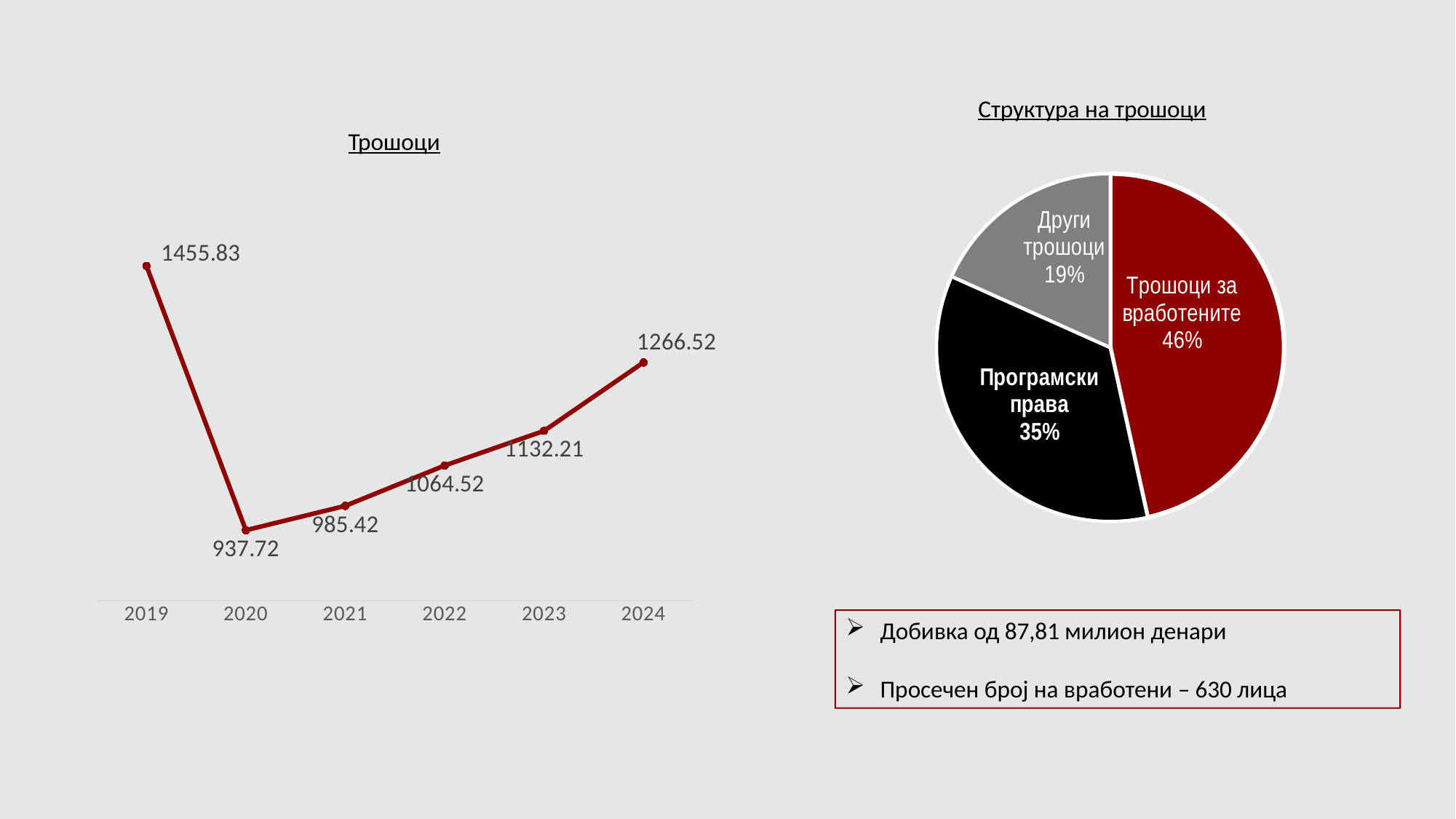
In the 'Трошоци' chart, which year has the highest value? 2019 In the 'Трошоци' chart, what is the value for 2022? 1064.52 In the 'Структура на трошоци' pie chart, which slice is the largest? Трошоци за вработените In the 'Трошоци' chart, how many years are plotted on the x axis? 6 In the 'Структура на трошоци' pie chart, how many slices are there? 3 In the 'Трошоци' chart, which is larger, the value for 2021 or the value for 2020? 2021 In the 'Трошоци' chart, do the values rise or fall from 2020 to 2024? rise In the 'Структура на трошоци' pie chart, what share does 'Програмски права' have? 35% In the 'Трошоци' chart, what is the value for 2019? 1455.83 In the 'Трошоци' chart, what is the difference between the values for 2024 and 2023? 134.31 What kind of chart is the 'Трошоци' chart? line chart In the 'Трошоци' chart, which year has the lowest value? 2020